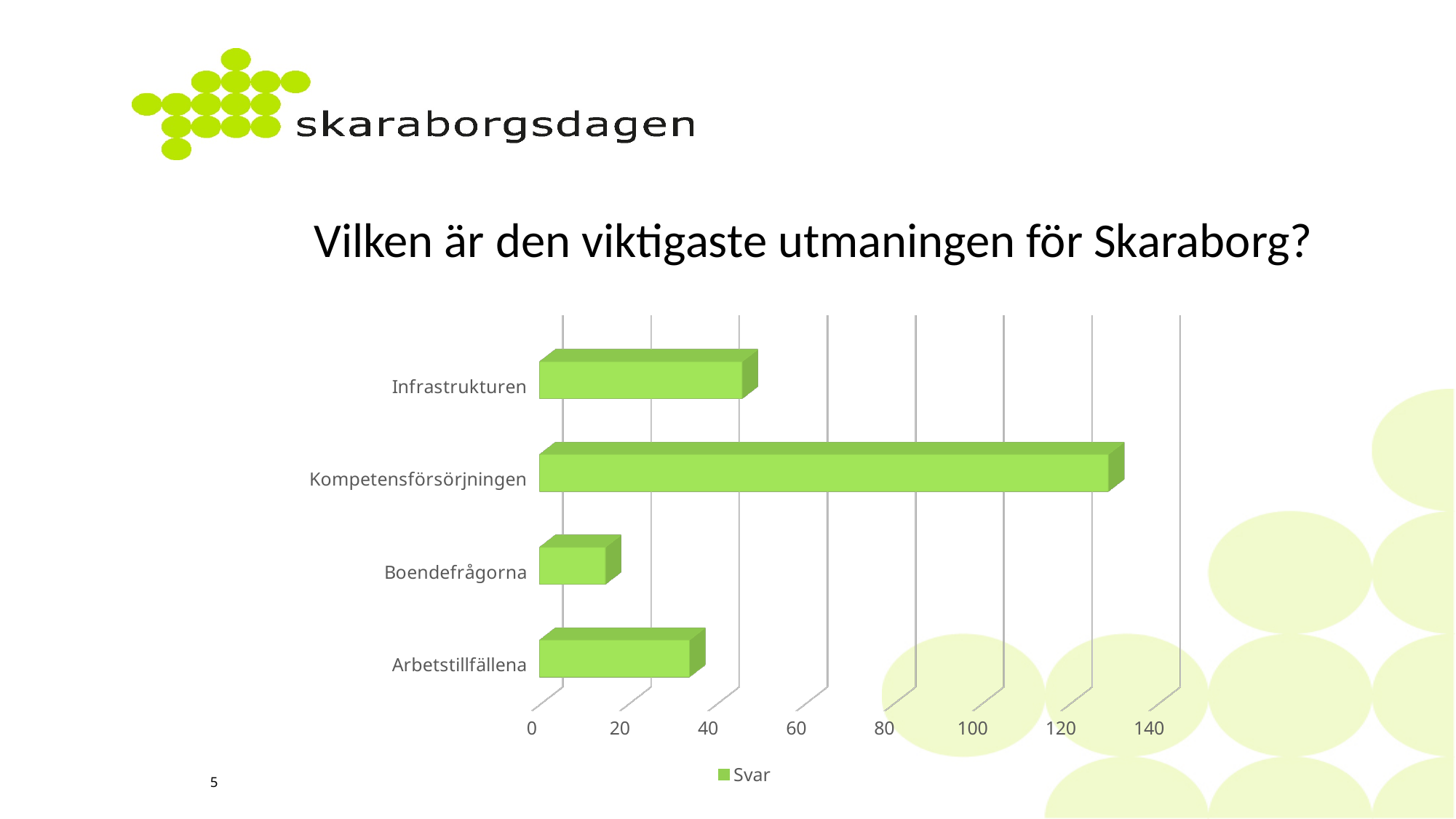
What kind of chart is shown on the slide? bar chart Which category has the lowest value? Boendefrågorna Is the value for Kompetensförsörjningen greater or less than 120? greater How many categories are shown in the chart? 4 Is the value for Arbetstillfällena greater or less than 20? greater Is the value for Boendefrågorna greater or less than 20? less Which category has the highest value? Kompetensförsörjningen What is the title of the chart? Vilken är den viktigaste utmaningen för Skaraborg? Which is larger, the value for Infrastrukturen or the value for Arbetstillfällena? Infrastrukturen What is the name of the series shown in the legend? Svar How many series does the legend list? 1